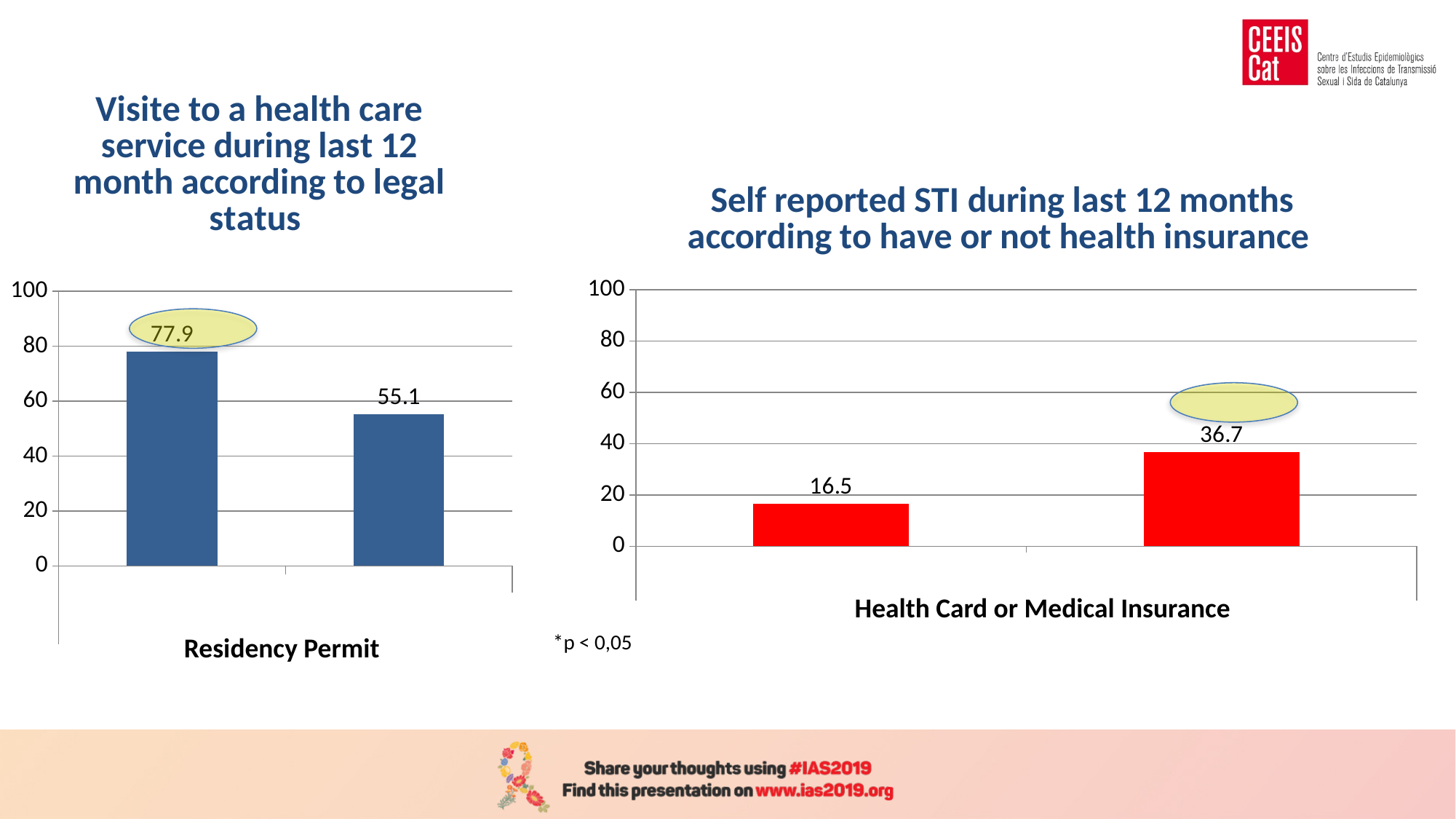
In the right chart (Self reported STI during last 12 months according to have or not health insurance), what is the difference between the two bars? 20.2 In the right chart (Self reported STI during last 12 months according to have or not health insurance), what is the value of the left bar? 16.5 In the left chart (Visite to a health care service during last 12 month according to legal status), what is the value of the left bar? 77.9 What kind of chart is the right chart (Self reported STI during last 12 months according to have or not health insurance)? bar chart In the left chart (Visite to a health care service during last 12 month according to legal status), what is the difference between the two bars? 22.8 In the left chart (Visite to a health care service during last 12 month according to legal status), how many bars are plotted? 2 In the left chart (Visite to a health care service during last 12 month according to legal status), which bar is higher, the left or the right? the left bar In the right chart (Self reported STI during last 12 months according to have or not health insurance), what is the x-axis title? Health Card or Medical Insurance In the left chart (Visite to a health care service during last 12 month according to legal status), what is the value of the right bar? 55.1 In the left chart (Visite to a health care service during last 12 month according to legal status), what is the x-axis title? Residency Permit In the right chart (Self reported STI during last 12 months according to have or not health insurance), what is the value of the right bar? 36.7 In the right chart (Self reported STI during last 12 months according to have or not health insurance), is the value of the right bar greater or less than 40? less